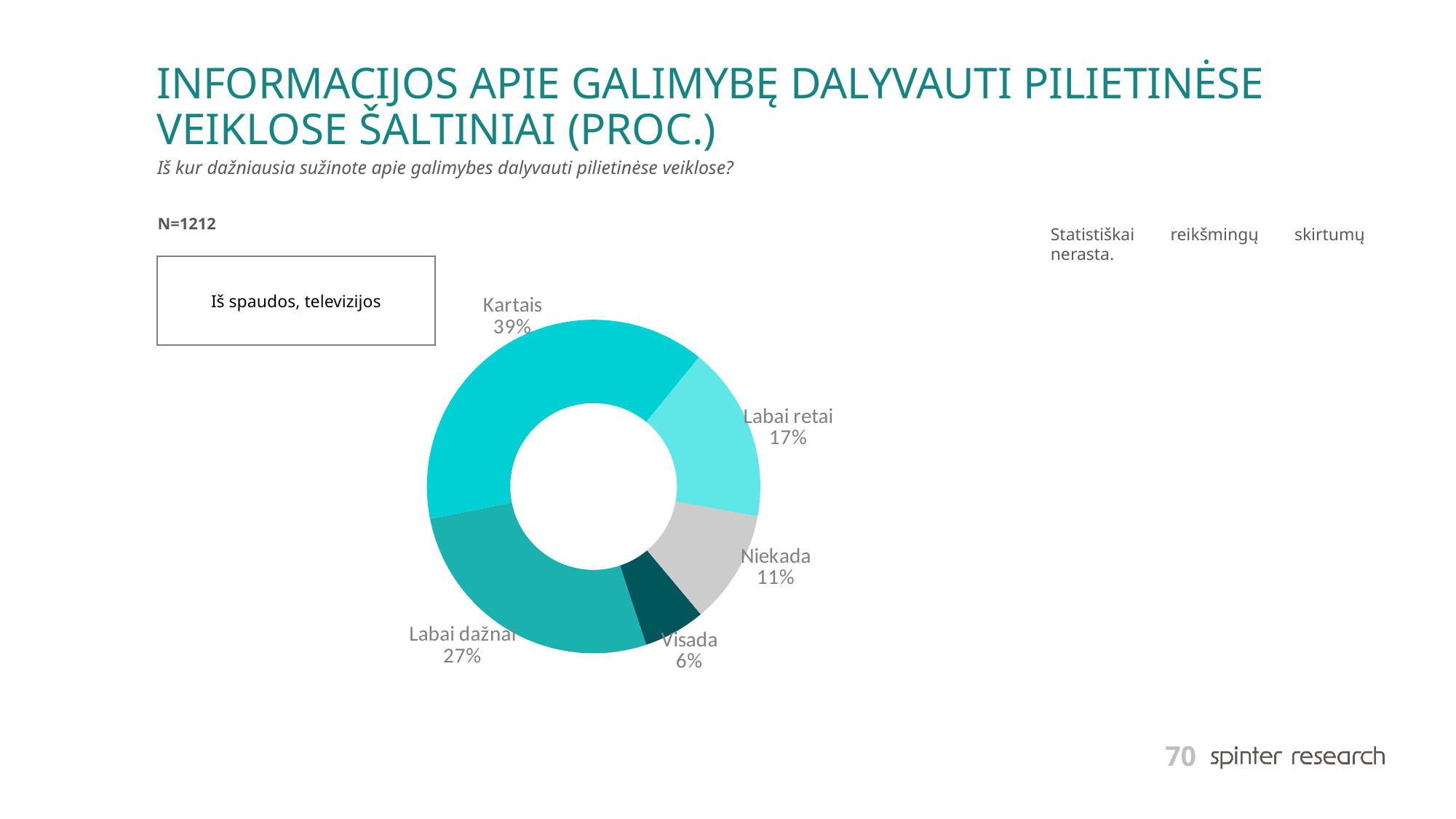
What percentage of respondents answered "Niekada"? 11% Which category has the smallest share of the pie? Visada How many categories are shown in the chart? 5 What kind of chart is shown on the slide? Pie chart (doughnut) Which category has the largest share of the pie? Kartais What percentage of respondents answered "Labai retai"? 17% What is the difference in percentage points between "Kartais" and "Labai dažnai"? 12 What is the sample size (N) stated on the slide? N=1212 Which is larger, the share for "Labai retai" or the share for "Niekada"? Labai retai What percentage of respondents answered "Visada"? 6% What percentage of respondents answered "Kartais"? 39% What percentage of respondents answered "Labai dažnai"? 27%